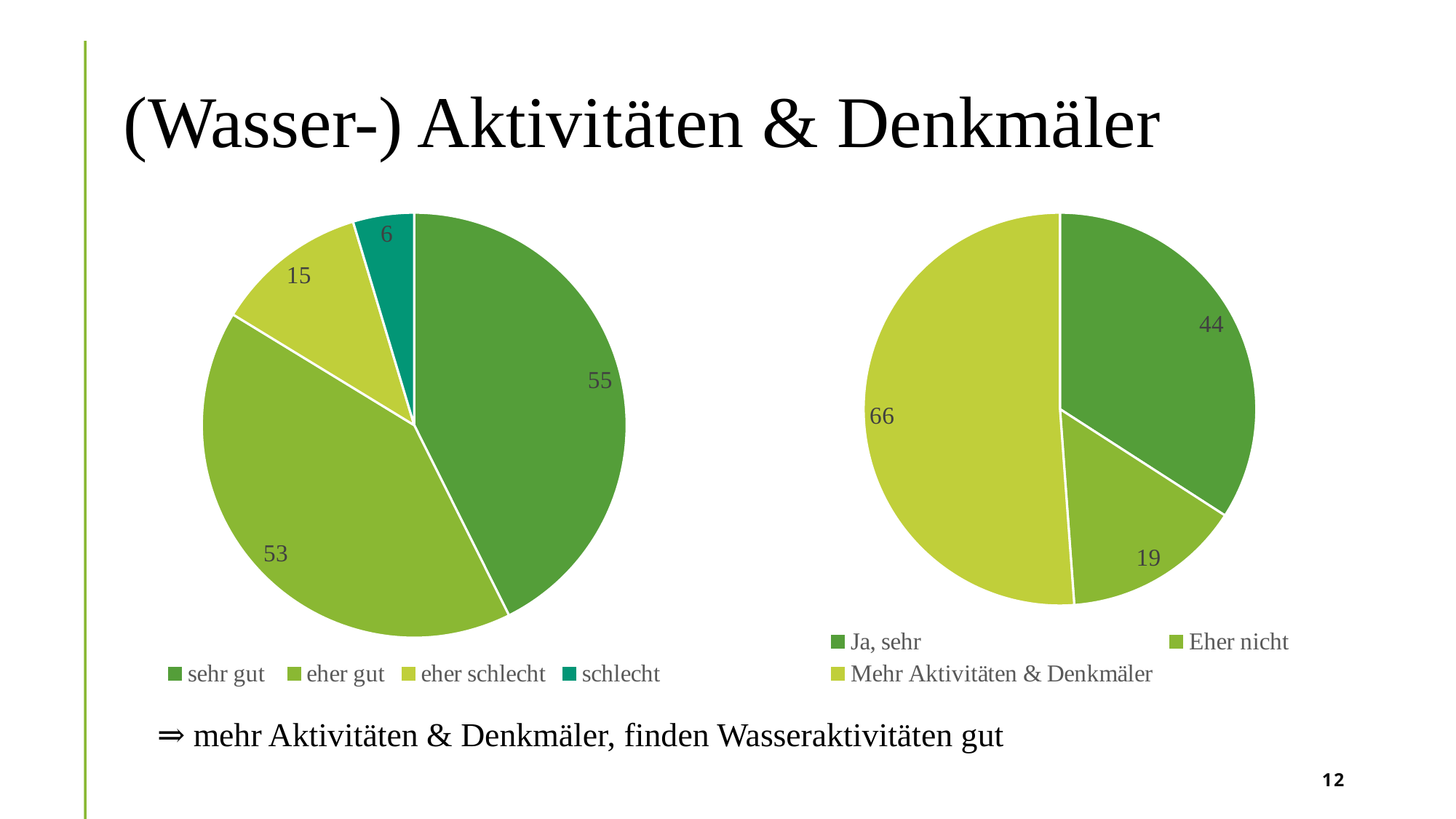
In the left pie chart, what is the value for "eher schlecht"? 15 In the right pie chart, which category has the largest slice? Mehr Aktivitäten & Denkmäler In the left pie chart, what is the difference between "eher gut" and "eher schlecht"? 38 In the right pie chart, which is larger, "Ja, sehr" or "Eher nicht"? Ja, sehr How many categories does the left pie chart show? 4 What type of chart is shown on the right side of the slide? Pie chart In the left pie chart, which category has the smallest slice? schlecht In the right pie chart, what is the value for "Mehr Aktivitäten & Denkmäler"? 66 In the left pie chart, what is the value for "sehr gut"? 55 In the right pie chart, what is the value for "Eher nicht"? 19 In the right pie chart, what is the difference between "Mehr Aktivitäten & Denkmäler" and "Ja, sehr"? 22 In the left pie chart, which category has the largest slice? sehr gut